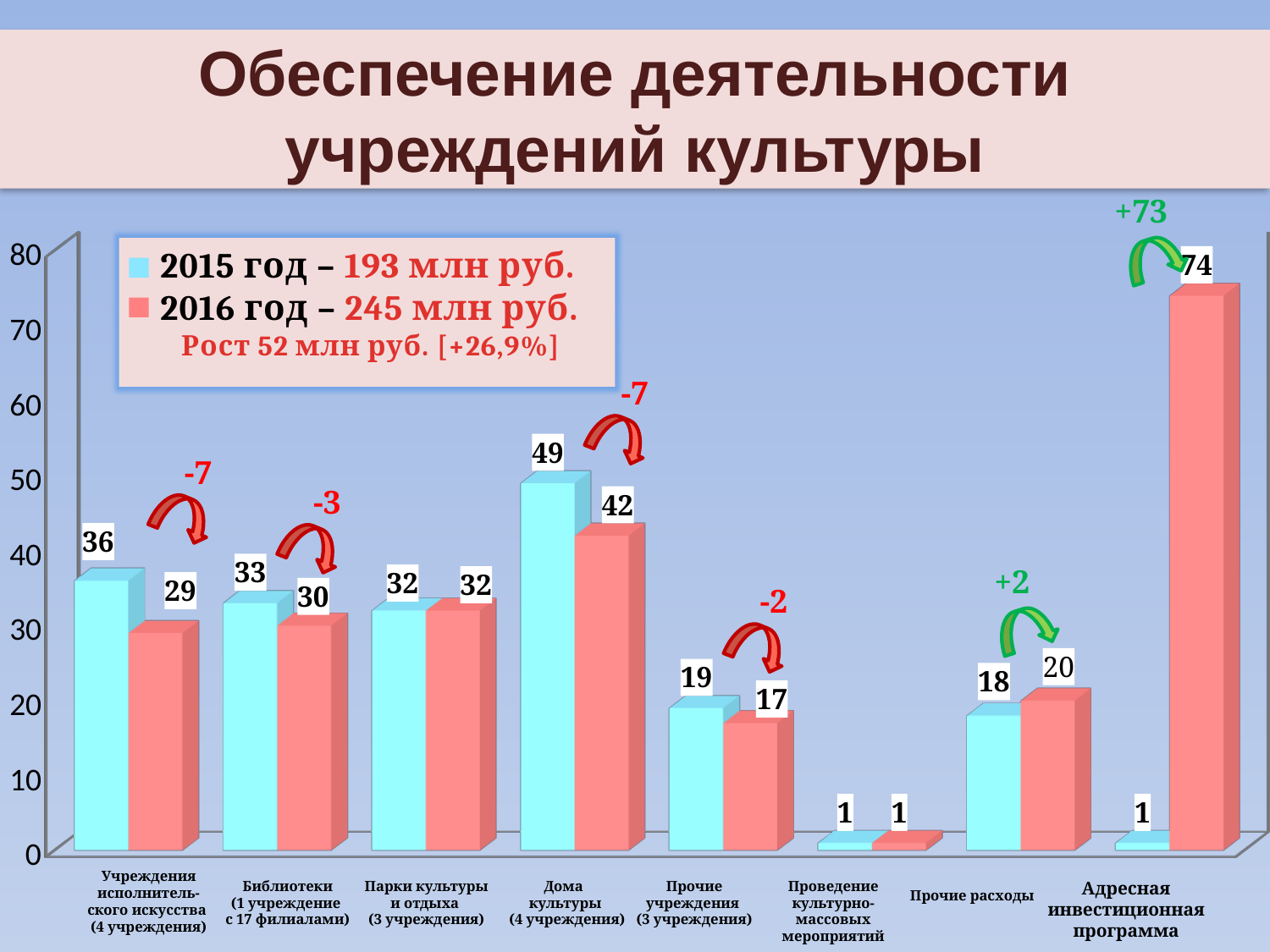
Which category has the highest 2015 год value? Дома культуры What is the 2015 год value for Дома культуры? 49 What kind of chart is shown on the slide? Bar chart Which is larger for Прочие расходы: the 2015 год value or the 2016 год value? 2016 год How many categories are shown on the x axis? 8 What is the difference between the 2015 год and 2016 год values for Учреждения исполнительского искусства? 7 What is the 2015 год value for Прочие учреждения? 19 How many series does the legend list? 2 According to the legend, what is the total for 2016 год? 245 млн руб. What is the 2016 год value for Адресная инвестиционная программа? 74 What is the 2016 год value for Библиотеки? 30 Which category has the highest 2016 год value? Адресная инвестиционная программа